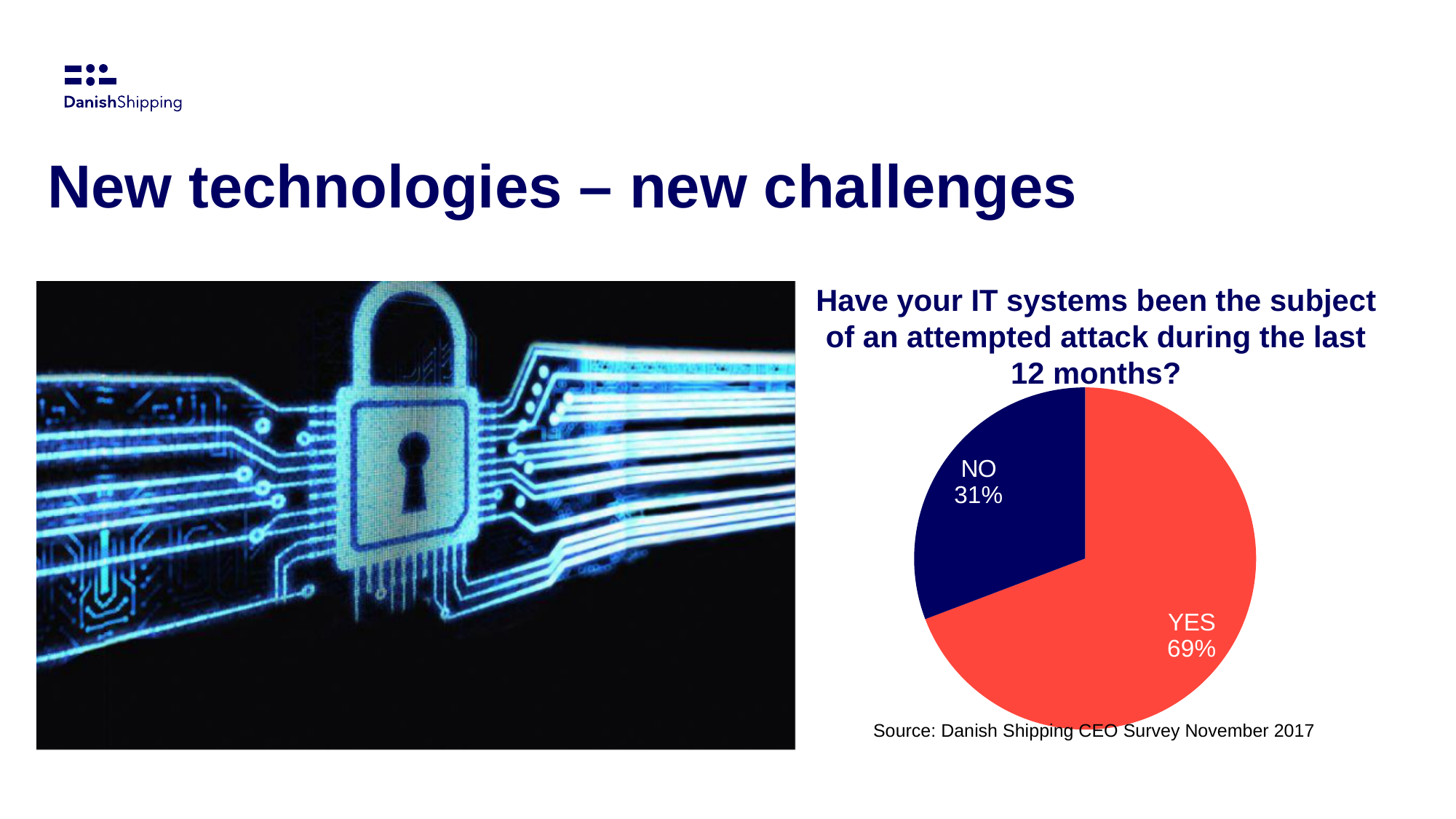
What percentage of respondents answered NO in the pie chart? 31% What kind of chart is shown on the slide? Pie chart What is the difference in percentage points between the YES and NO shares? 38 Which is larger, the YES share or the NO share? YES What percentage of respondents answered YES to whether their IT systems had been the subject of an attempted attack during the last 12 months? 69% Which response has the smallest share of the pie chart? NO What colour is the YES slice of the pie chart? Red What is the source cited below the pie chart? Danish Shipping CEO Survey November 2017 How many slices does the pie chart have? 2 What is the title of the pie chart? Have your IT systems been the subject of an attempted attack during the last 12 months? Which response has the largest share of the pie chart? YES